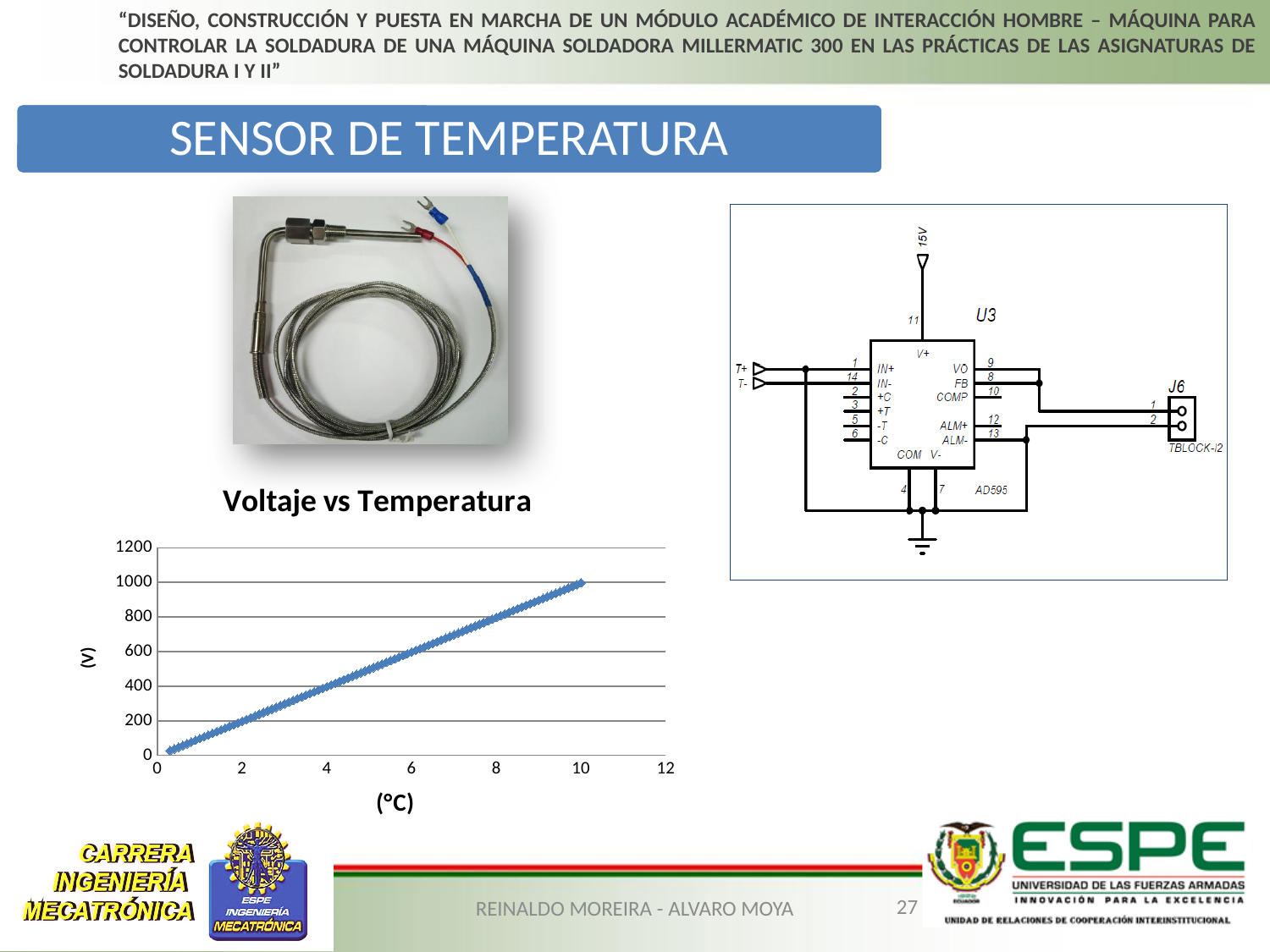
In the "Voltaje vs Temperatura" chart, what is the maximum value shown on the y axis? 1200 What type of chart is "Voltaje vs Temperatura"? scatter chart In the "Voltaje vs Temperatura" chart, at which x value does the plotted data reach its highest point? 10 In the "Voltaje vs Temperatura" chart, which has the larger y value: the point at x = 8 or the point at x = 2? x = 8 In the "Voltaje vs Temperatura" chart, is the value at x = 8 greater or less than 1000? less In the "Voltaje vs Temperatura" chart, do the values rise or fall as the x axis increases? rise What is the title of the chart on the slide? Voltaje vs Temperatura In the "Voltaje vs Temperatura" chart, is the value at x = 6 greater or less than 400? greater What is the label on the y axis of the "Voltaje vs Temperatura" chart? (V) In the "Voltaje vs Temperatura" chart, is the value at x = 2 greater or less than 400? less